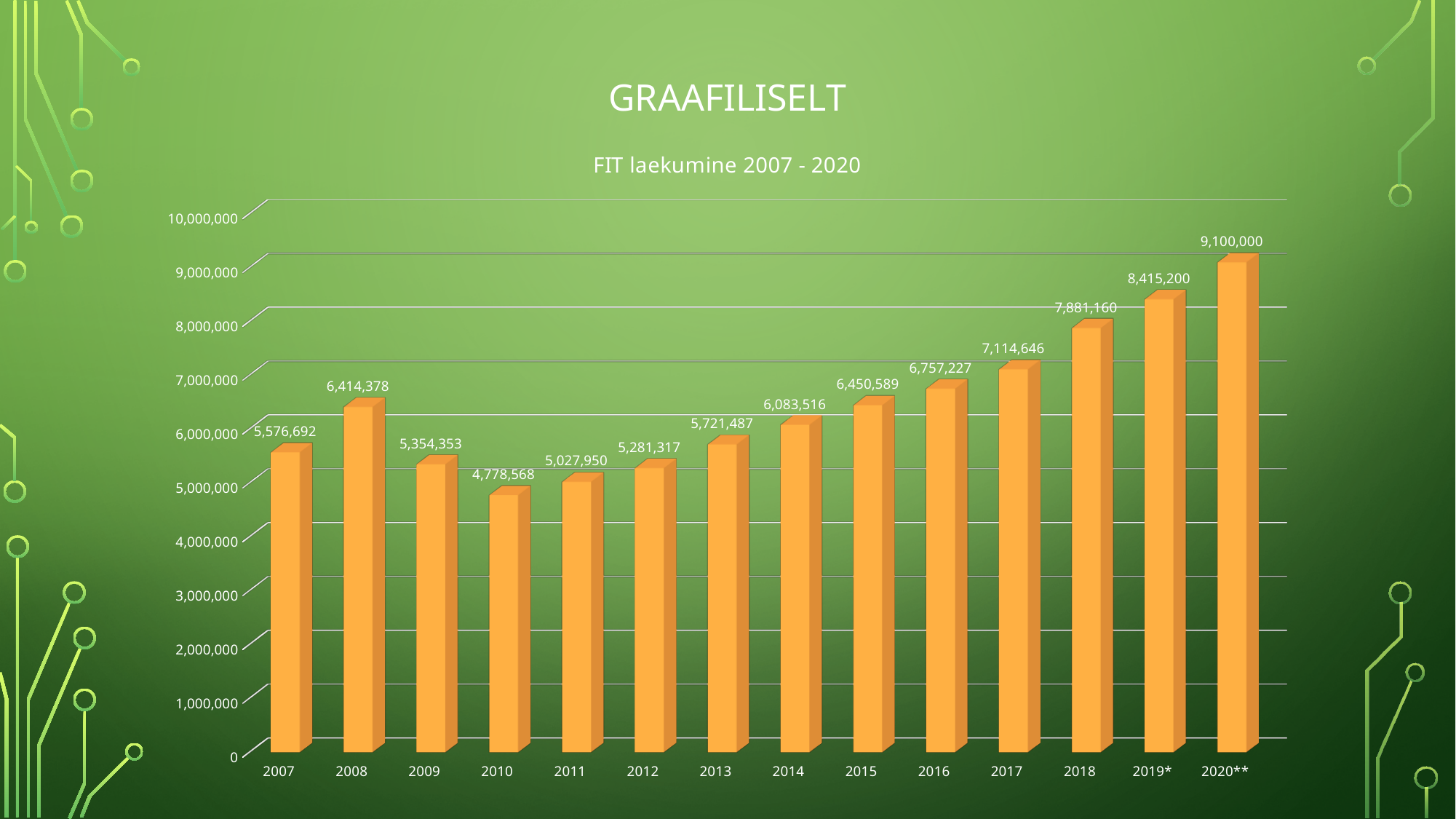
What is the difference between the values for 2019* and 2018? 534,040 Which year has the highest value? 2020** Which year has the lowest value? 2010 What is the title of the chart? FIT laekumine 2007 - 2020 How many years are shown on the x axis? 14 Which is larger, the value for 2008 or the value for 2013? 2008 What is the value for 2020**? 9,100,000 What is the value for 2015? 6,450,589 Do the values rise or fall from 2010 to 2020**? rise What is the value for 2010? 4,778,568 What kind of chart is shown? bar chart Is the value for 2017 greater or less than 7,000,000? greater